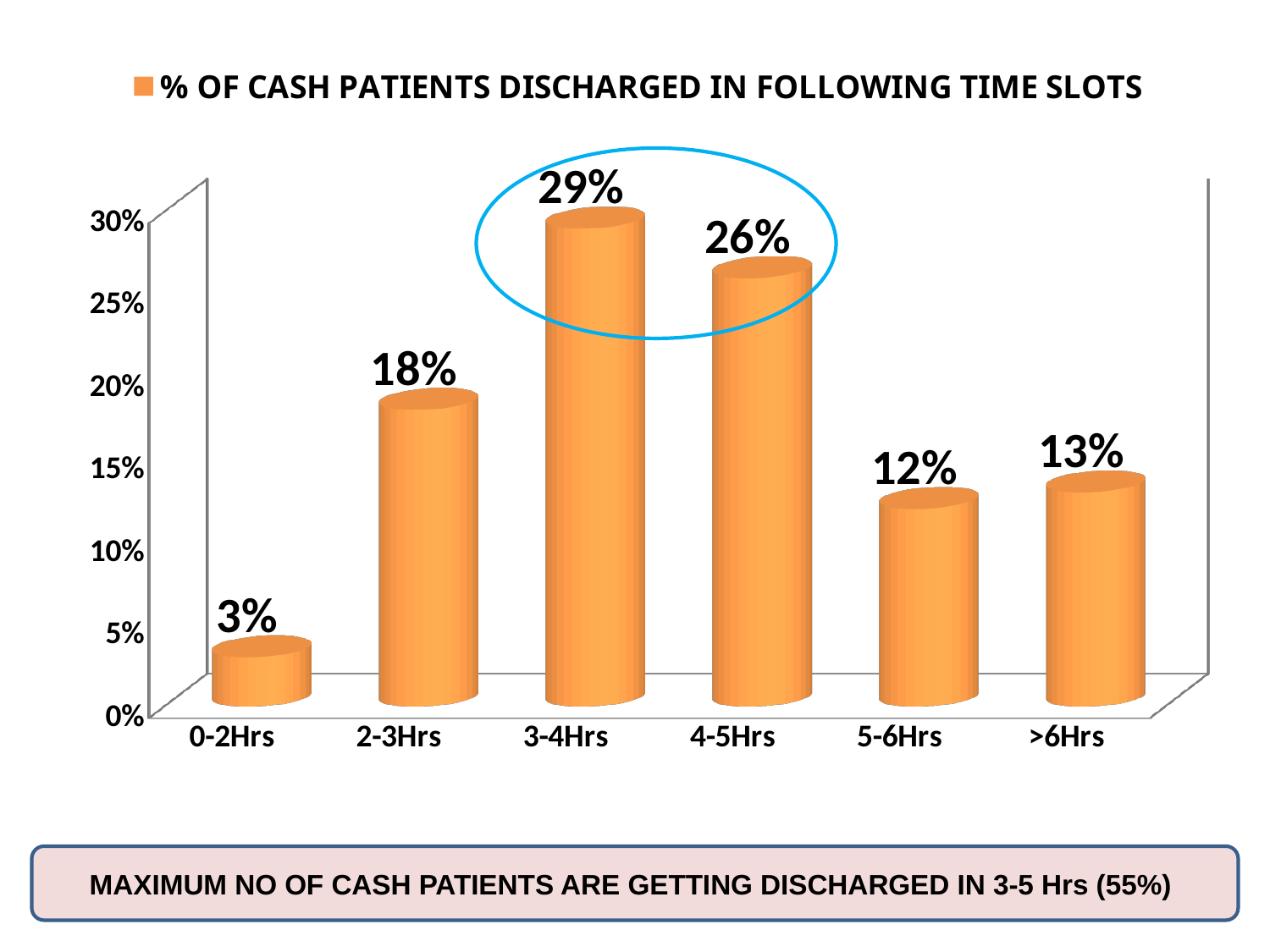
What is the difference between the percentages for the 2-3Hrs and 5-6Hrs time slots? 6% What percentage of cash patients were discharged in the 3-4Hrs time slot? 29% Which time slot has a larger percentage, 5-6Hrs or >6Hrs? >6Hrs Which time slot has the lowest percentage of cash patients discharged? 0-2Hrs Is the value for the 2-3Hrs time slot greater or less than 20%? less Which time slot has the highest percentage of cash patients discharged? 3-4Hrs What is the difference between the percentages for the 3-4Hrs and 4-5Hrs time slots? 3% How many time slot categories are shown on the x axis? 6 What is the title of the chart shown in the legend? % OF CASH PATIENTS DISCHARGED IN FOLLOWING TIME SLOTS What percentage of cash patients were discharged in the 0-2Hrs time slot? 3% What is the value shown for the >6Hrs time slot? 13% What kind of chart is shown on the slide? Bar chart